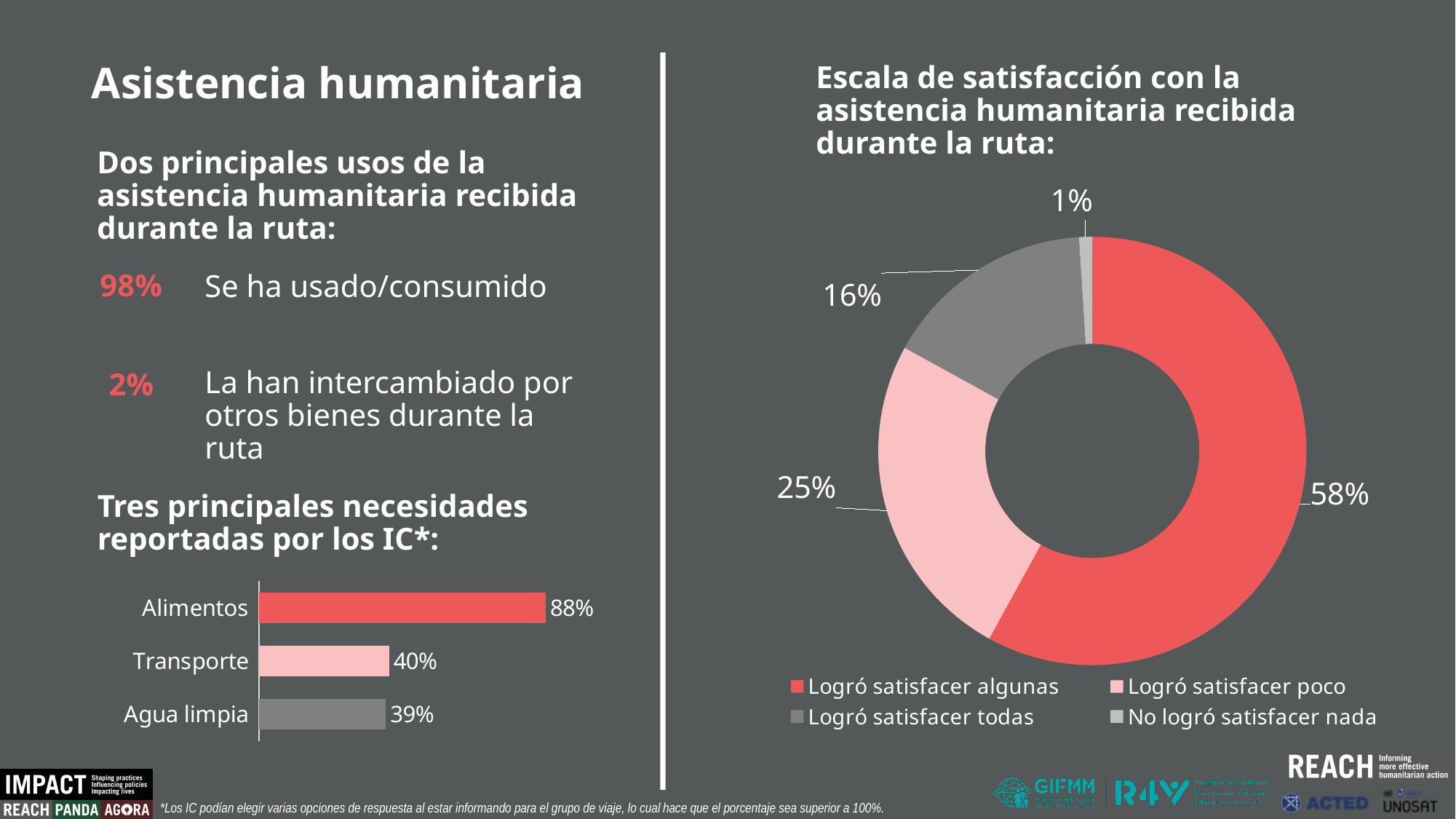
In the bar chart 'Tres principales necesidades reportadas por los IC', what is the value for Alimentos? 88% What kind of chart is 'Tres principales necesidades reportadas por los IC'? Bar chart In the doughnut chart 'Escala de satisfacción con la asistencia humanitaria recibida durante la ruta', which category has the smallest share? No logró satisfacer nada In the doughnut chart 'Escala de satisfacción con la asistencia humanitaria recibida durante la ruta', which is larger: 'Logró satisfacer poco' or 'Logró satisfacer todas'? Logró satisfacer poco How many entries does the legend of the doughnut chart 'Escala de satisfacción con la asistencia humanitaria recibida durante la ruta' list? 4 In the bar chart 'Tres principales necesidades reportadas por los IC', what is the value for Agua limpia? 39% In the doughnut chart 'Escala de satisfacción con la asistencia humanitaria recibida durante la ruta', what share is 'Logró satisfacer algunas'? 58% In the doughnut chart 'Escala de satisfacción con la asistencia humanitaria recibida durante la ruta', what share is 'Logró satisfacer todas'? 16% In the bar chart 'Tres principales necesidades reportadas por los IC', what is the difference between Alimentos and Transporte? 48% In the bar chart 'Tres principales necesidades reportadas por los IC', how many categories are shown? 3 In the bar chart 'Tres principales necesidades reportadas por los IC', what is the value for Transporte? 40% In the bar chart 'Tres principales necesidades reportadas por los IC', which category has the highest value? Alimentos